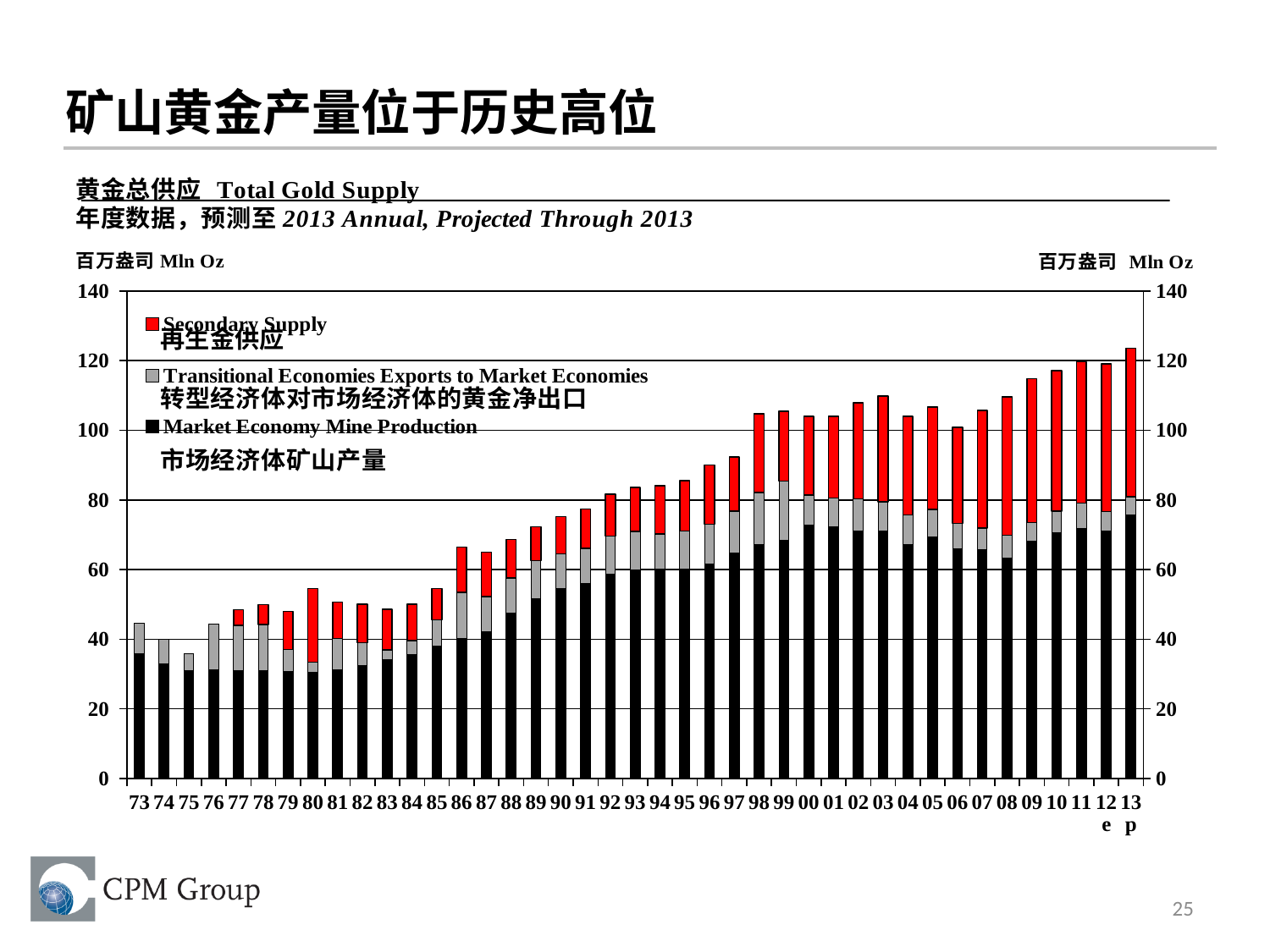
How many series does the legend list? 3 Which year has a larger total gold supply, 1973 or 2013? 2013 What colour represents Secondary Supply in the chart? Red Is the total gold supply for 2013 greater or less than 100? greater What kind of chart is shown on the slide? Stacked bar chart How many years are plotted along the x axis? 41 Is the total gold supply for 1986 greater or less than 60? greater Which year has the highest total gold supply? 2013 Is the total gold supply for 1975 greater or less than 40? less Which year has the lowest total gold supply? 1975 Does the total gold supply generally rise or fall from 1973 to 2013? rise